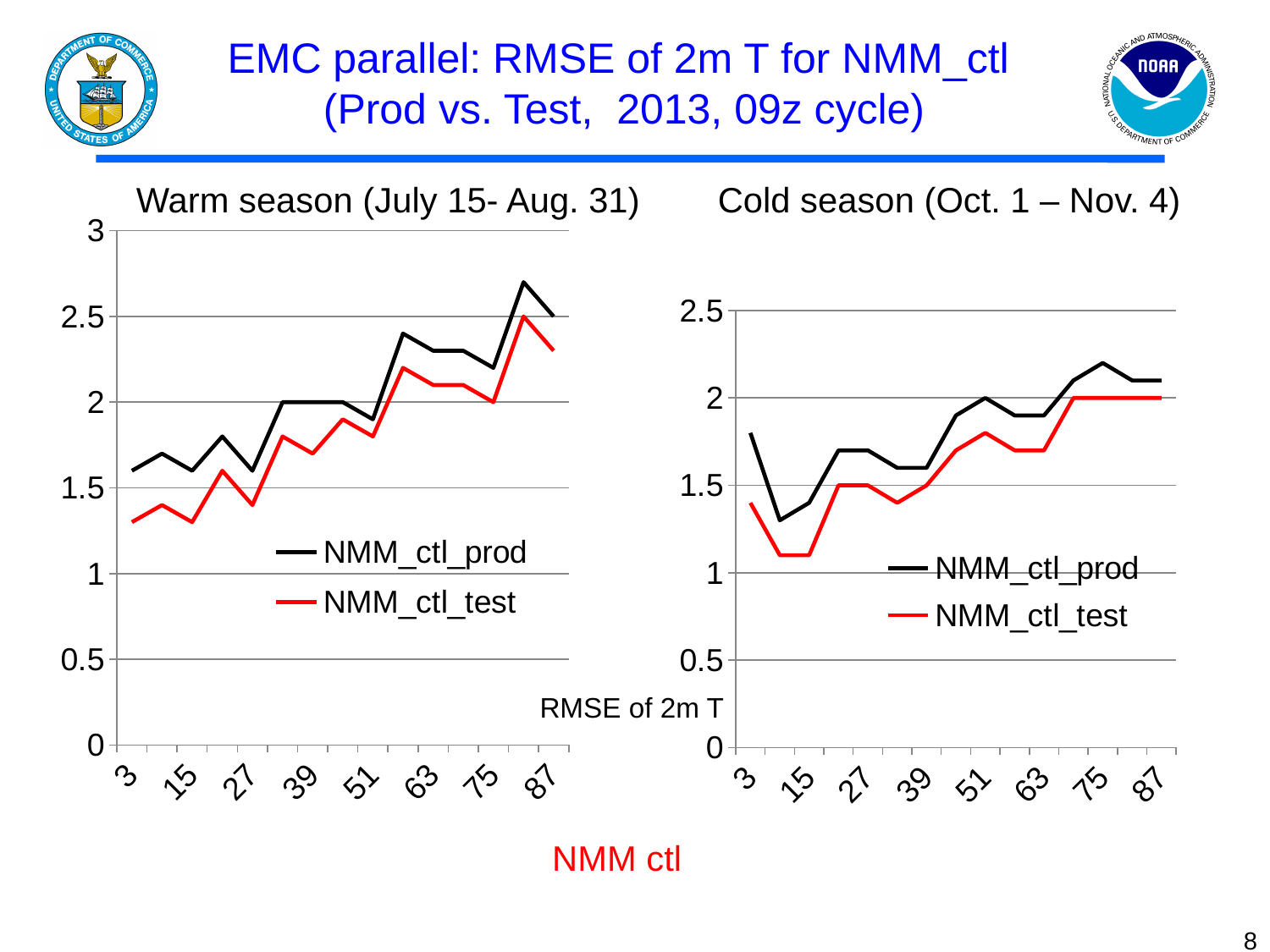
What type of chart is the Warm season chart? line chart In the Warm season chart, which series is drawn in red? NMM_ctl_test How many forecast-hour labels are shown on the x axis of the Cold season chart? 8 In the Cold season chart, is the NMM_ctl_prod value at forecast hour 3 greater or less than 1.5? greater How many series does the legend of the Cold season chart list? 2 In the Cold season chart, is the NMM_ctl_test value at forecast hour 15 greater or less than 1.5? less In the Warm season chart, is the NMM_ctl_test value at forecast hour 3 greater or less than 1.5? less In the Cold season chart, do the NMM_ctl_test values generally rise or fall from forecast hour 3 to 87? rise In the Cold season chart, at forecast hour 15, which series has the lower value, NMM_ctl_prod or NMM_ctl_test? NMM_ctl_test In the Warm season chart, at forecast hour 87, which series has the higher value, NMM_ctl_prod or NMM_ctl_test? NMM_ctl_prod In the Warm season chart, do the NMM_ctl_prod values generally rise or fall from forecast hour 3 to 87? rise